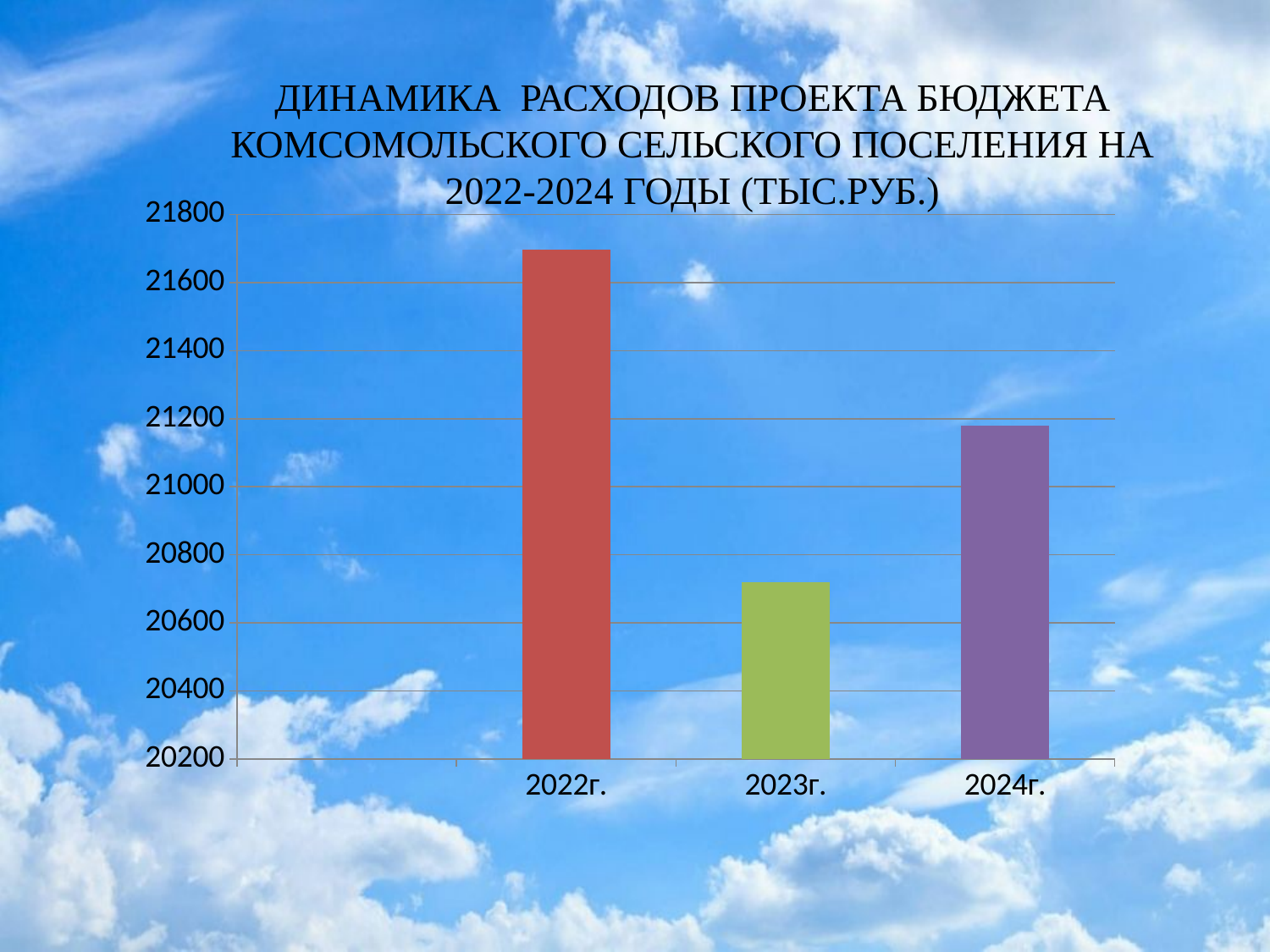
Is the value for 2024г. greater or less than 21000? greater How many years (categories) are plotted on the chart? 3 What colour is the bar for 2024г.? purple Which is larger, the value for 2022г. or the value for 2024г.? 2022г. Does the value rise or fall from 2022г. to 2023г.? fall Is the value for 2023г. greater or less than 20600? greater Which year has the highest expenditure value on the chart? 2022г. Is the value for 2023г. greater or less than 20800? less Which is larger, the value for 2023г. or the value for 2024г.? 2024г. What kind of chart is shown on the slide? bar chart Which year has the lowest expenditure value on the chart? 2023г.